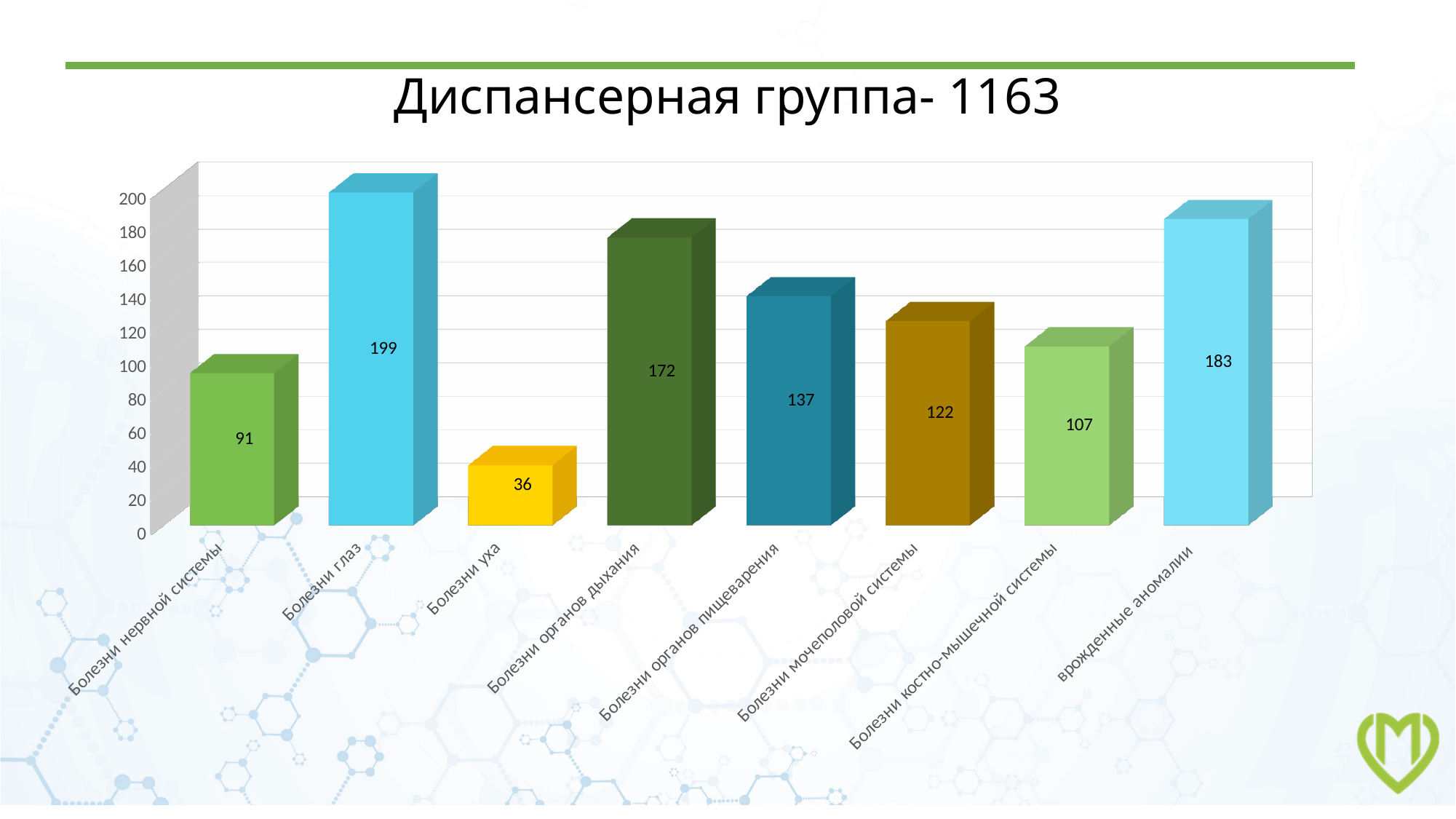
What is the difference between the values for Болезни органов пищеварения and Болезни мочеполовой системы? 15 What is the value for Болезни органов дыхания? 172 What kind of chart is shown on the slide? bar chart Which category has the highest value? Болезни глаз Which category has the lowest value? Болезни уха How many categories are shown in the chart? 8 Is the value for Болезни органов дыхания greater or less than 160? greater What is the value for Болезни уха? 36 Which is larger, the value for Болезни нервной системы or the value for Болезни костно-мышечной системы? Болезни костно-мышечной системы What is the title of the slide? Диспансерная группа- 1163 What is the value for врожденные аномалии? 183 What is the value for Болезни глаз? 199